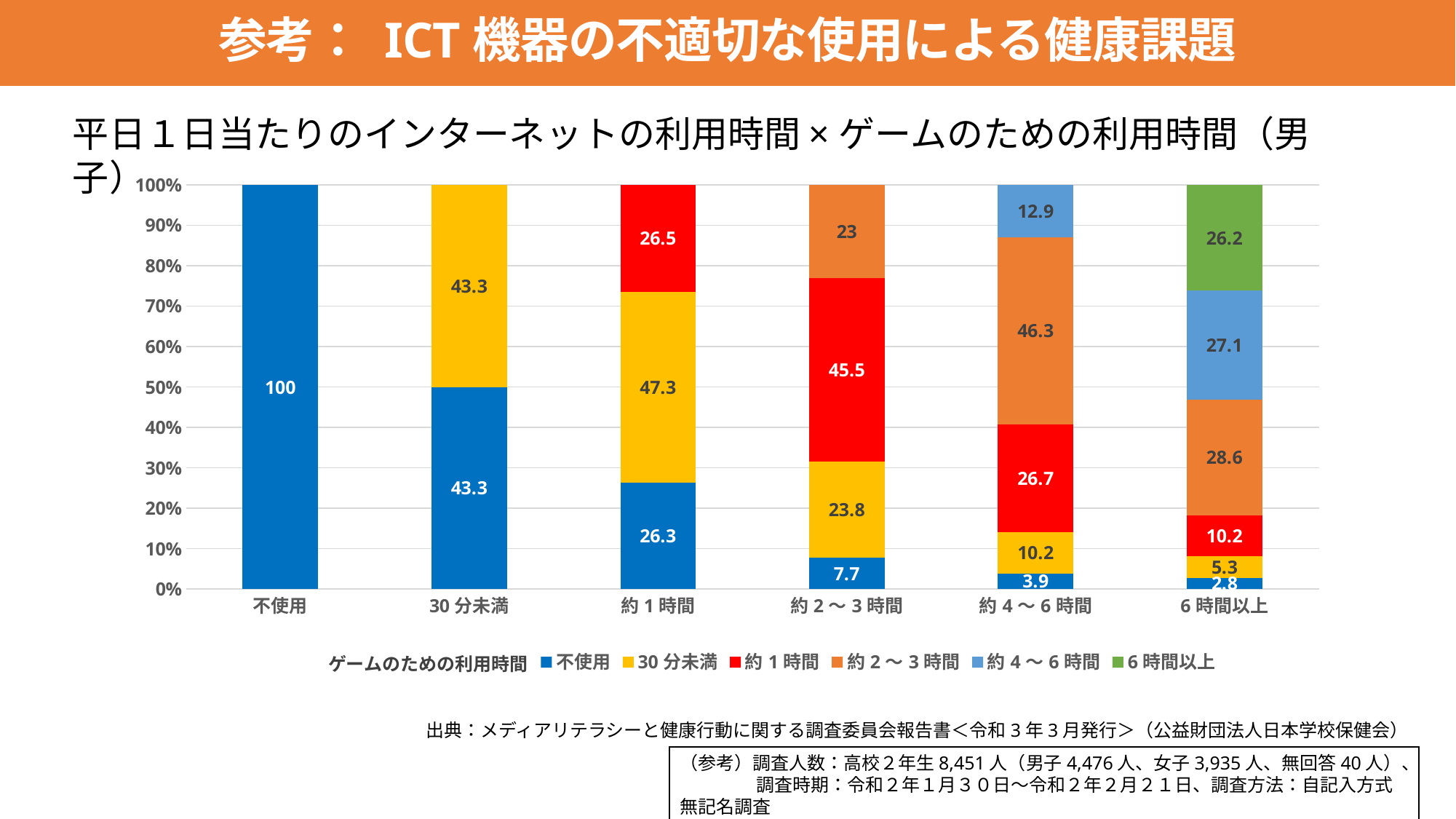
What is the value of the 不使用 (game) segment in the 約１時間 bar? 26.3 How many categories are shown on the x axis? 6 Which game-time segment is the smallest in the 約４～６時間 bar? 不使用 What is the difference between the 約１時間 segment and the 30分未満 segment in the 約２～３時間 bar? 21.7 What is the value of the 約２～３時間 (game) segment in the 約４～６時間 bar? 46.3 How many series does the legend list? 6 What is the value of the 約１時間 (game) segment in the 約２～３時間 bar? 45.5 Does the 不使用 (game) segment rise or fall as internet usage time increases along the x axis? Fall In the 約４～６時間 bar, which is larger: the 約２～３時間 segment or the 約１時間 segment? 約２～３時間 What kind of chart is shown on the slide? Stacked bar chart Which game-time segment is the largest in the ６時間以上 bar? 約２～３時間 What is the value of the ６時間以上 (game) segment in the ６時間以上 bar? 26.2